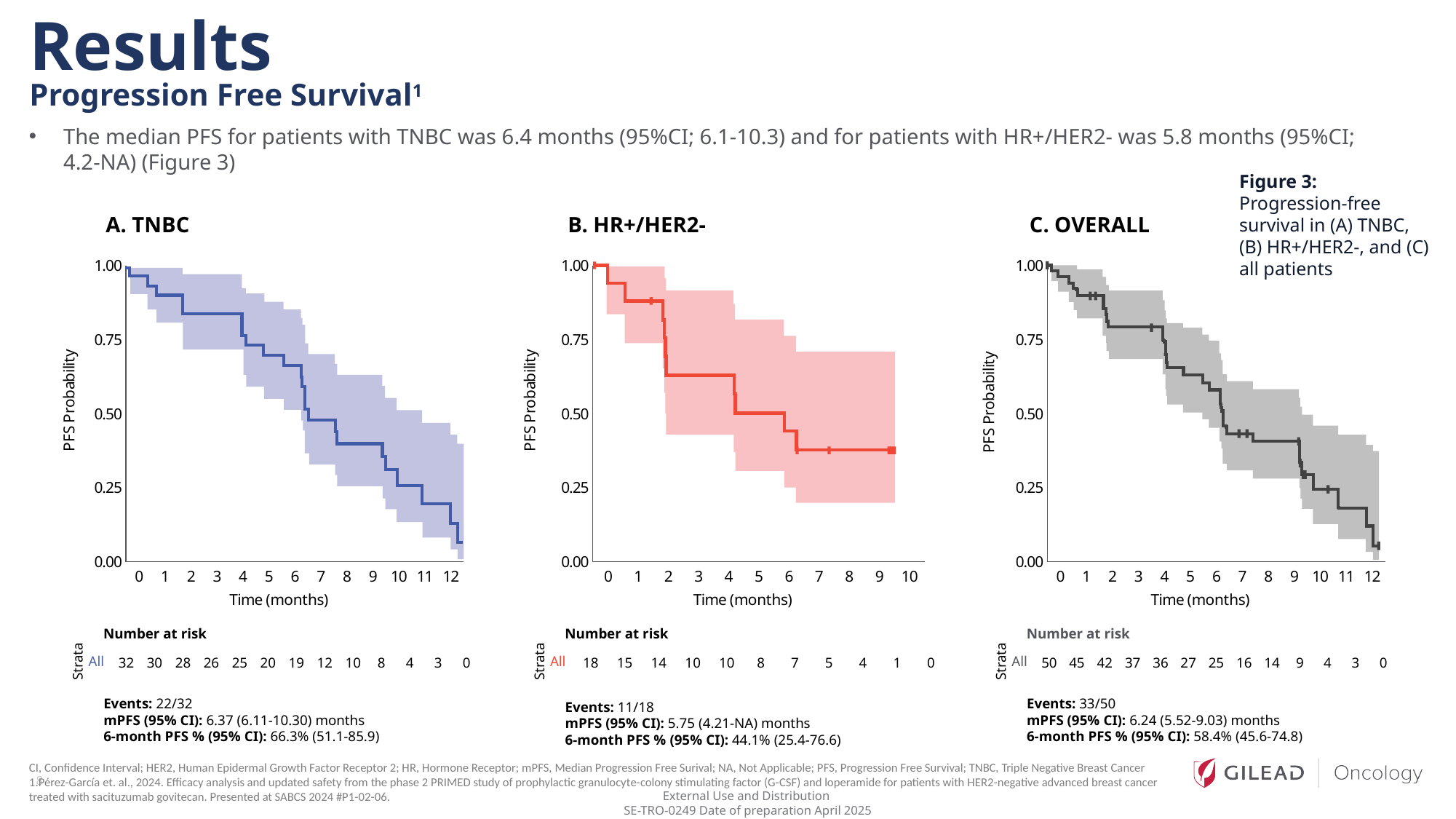
In chart A (TNBC), what is the number at risk at 0 months? 32 In chart B (HR+/HER2-), is the PFS probability at 3 months greater or less than 0.50? greater What kind of chart is chart C (OVERALL)? line chart (Kaplan-Meier survival curve) In chart A (TNBC), how many events are reported? 22/32 In chart A (TNBC), what is the difference between the number at risk at 0 months and at 6 months? 13 In chart A (TNBC), does the PFS probability rise or fall as time increases? fall In chart C (OVERALL), what is the number at risk at 6 months? 25 Which chart has the larger number at risk at 6 months, chart A (TNBC) or chart B (HR+/HER2-)? Chart A (TNBC) In chart C (OVERALL), what is the 6-month PFS % (95% CI)? 58.4% (45.6-74.8) In chart B (HR+/HER2-), what is the mPFS (95% CI)? 5.75 (4.21-NA) months In chart B (HR+/HER2-), what is the number at risk at 4 months? 10 In chart C (OVERALL), is the PFS probability at 8 months greater or less than 0.50? less